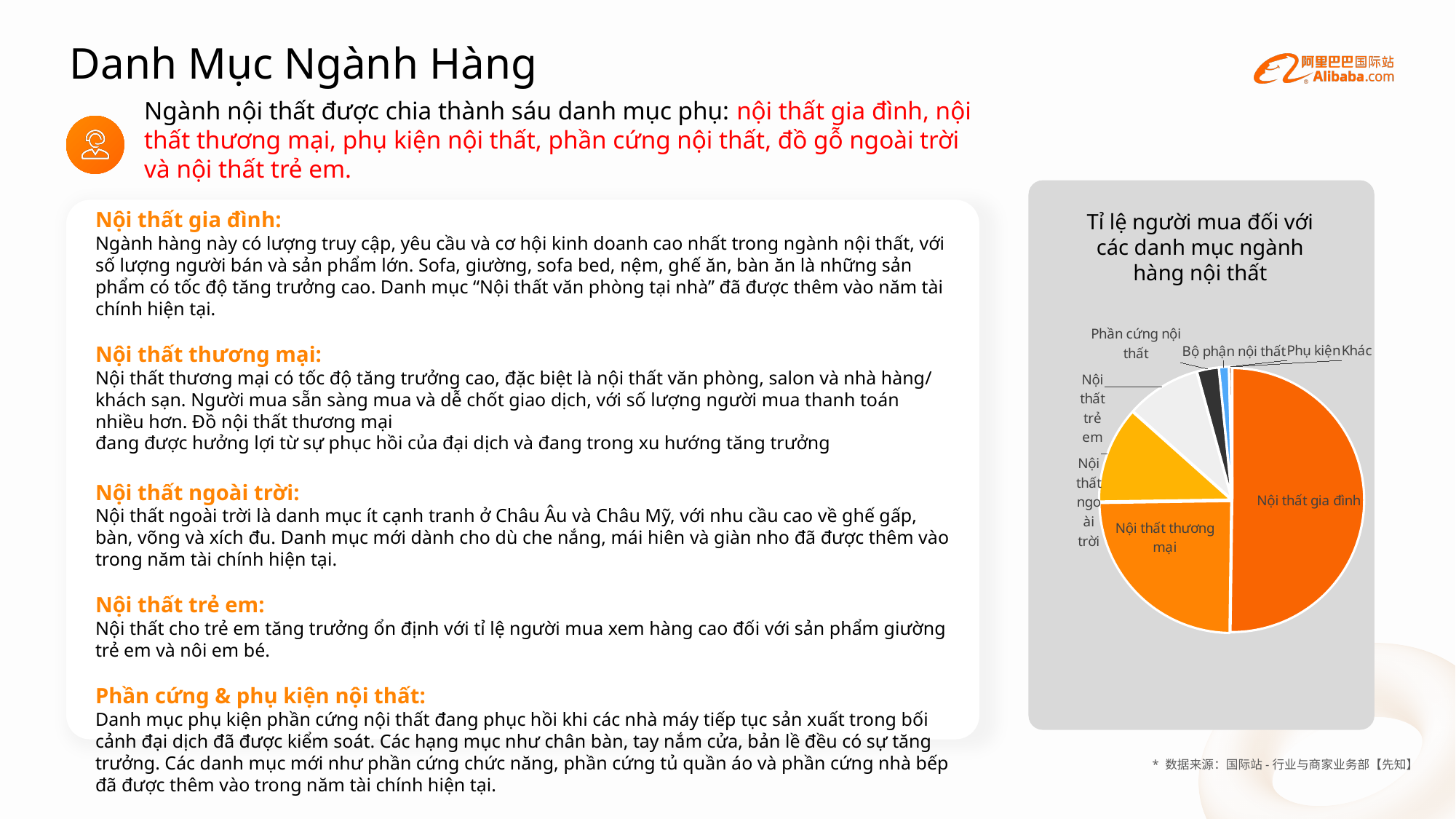
Which slice is larger in the pie chart, Nội thất gia đình or Nội thất thương mại? Nội thất gia đình Which category has the second-largest slice in the pie chart? Nội thất thương mại Which slice is larger in the pie chart, Nội thất thương mại or Nội thất ngoài trời? Nội thất thương mại Which slice is larger in the pie chart, Nội thất trẻ em or Phần cứng nội thất? Nội thất trẻ em How many categories are labelled in the pie chart? 8 What kind of chart is shown on the slide? Pie chart What is the title of the pie chart? Tỉ lệ người mua đối với các danh mục ngành hàng nội thất Which category has the largest slice in the pie chart? Nội thất gia đình What colour is the Nội thất ngoài trời slice in the pie chart? Yellow